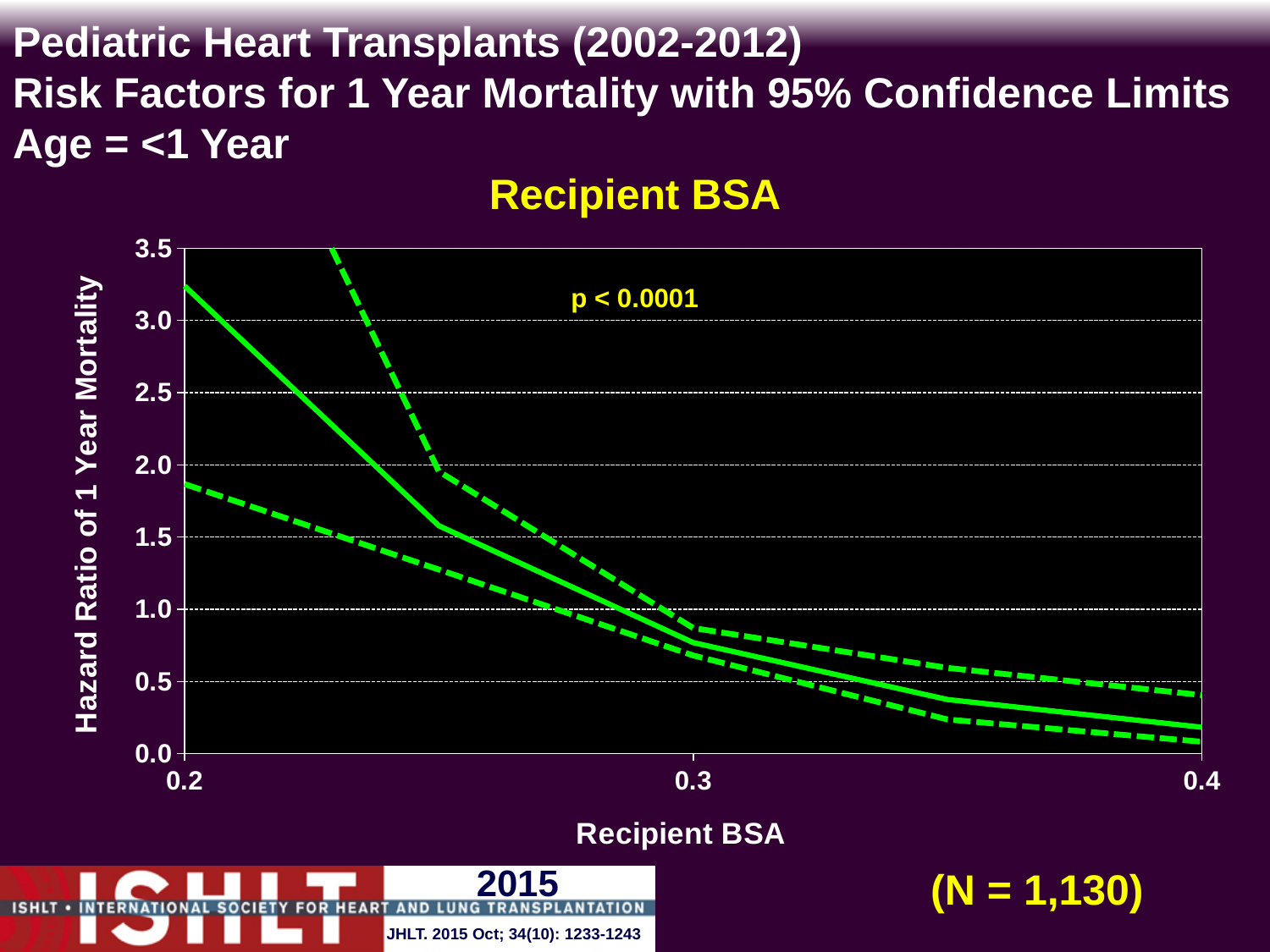
Is the hazard ratio (solid line) at a recipient BSA of 0.4 greater or less than 0.5? less What is the title of the chart? Recipient BSA Is the hazard ratio larger at a recipient BSA of 0.2 or at 0.4? 0.2 How many lines are plotted on the chart? 3 What is the label of the y axis? Hazard Ratio of 1 Year Mortality What p-value is printed on the chart? p < 0.0001 Is the upper confidence limit (upper dashed line) at a recipient BSA of 0.2 greater or less than 3.0? greater Is the hazard ratio (solid line) at a recipient BSA of 0.3 greater or less than 1.0? less Does the hazard ratio of 1 year mortality rise or fall as recipient BSA increases from 0.2 to 0.4? fall What kind of chart is shown on the slide? line chart